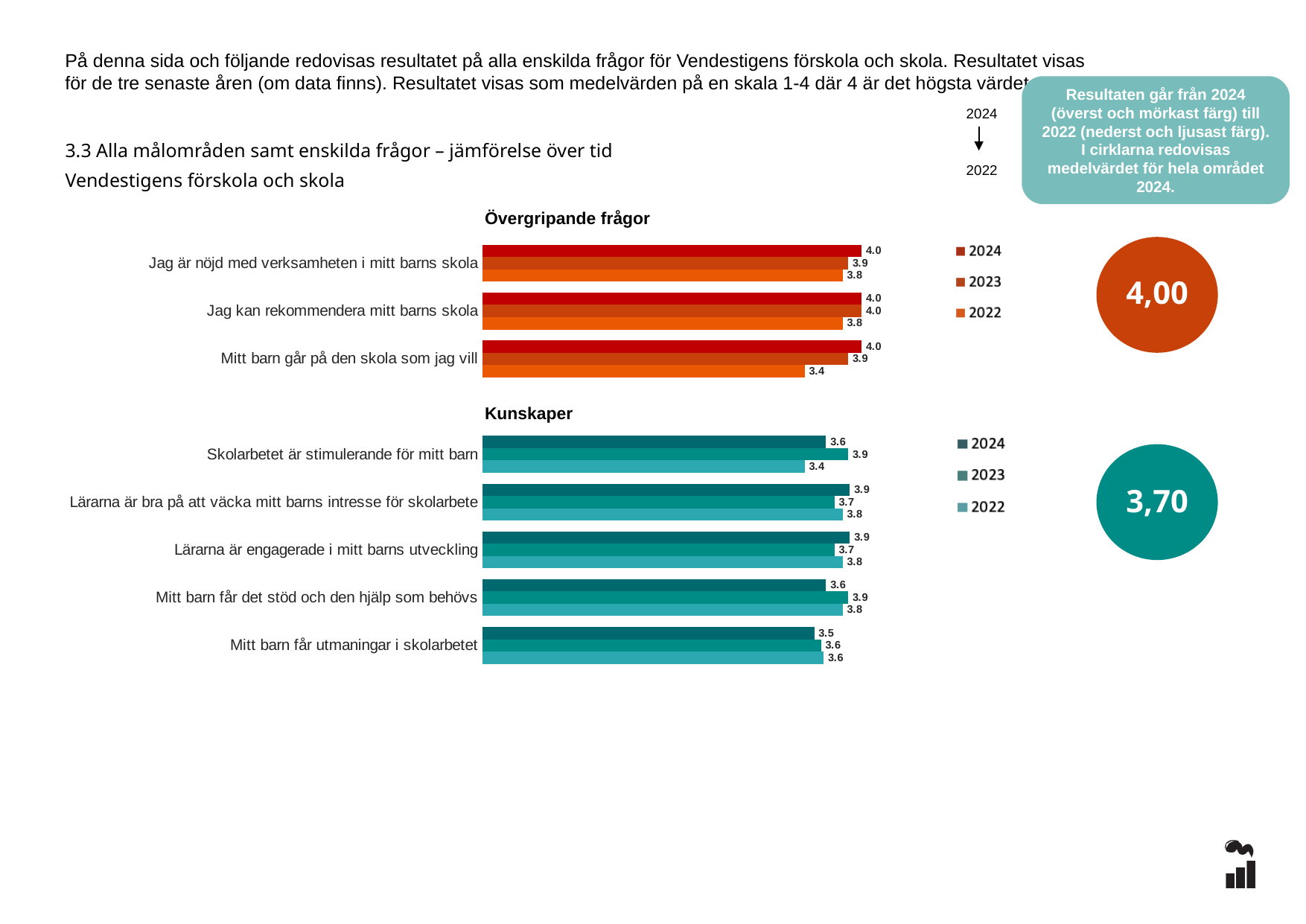
In the 'Kunskaper' chart, which category has the lowest 2022 value? Skolarbetet är stimulerande för mitt barn In the 'Kunskaper' chart, for 'Lärarna är engagerade i mitt barns utveckling', which is larger: the 2024 value or the 2023 value? 2024 In the 'Kunskaper' chart, what is the 2023 value for 'Skolarbetet är stimulerande för mitt barn'? 3.9 In the 'Kunskaper' chart, what is the 2024 value for 'Mitt barn får utmaningar i skolarbetet'? 3.5 In the 'Kunskaper' chart, what is the difference between the 2023 and 2024 values for 'Mitt barn får det stöd och den hjälp som behövs'? 0.3 How many categories are shown in the 'Kunskaper' chart? 5 What kind of chart is the 'Kunskaper' chart? Bar chart In the 'Kunskaper' chart, which category has the lowest 2024 value? Mitt barn får utmaningar i skolarbetet How many series does the legend of the 'Övergripande frågor' chart list? 3 In the 'Övergripande frågor' chart, what is the 2022 value for 'Mitt barn går på den skola som jag vill'? 3.4 In the 'Övergripande frågor' chart, what is the 2023 value for 'Jag kan rekommendera mitt barns skola'? 4.0 In the 'Övergripande frågor' chart, what is the difference between the 2024 and 2022 values for 'Mitt barn går på den skola som jag vill'? 0.6